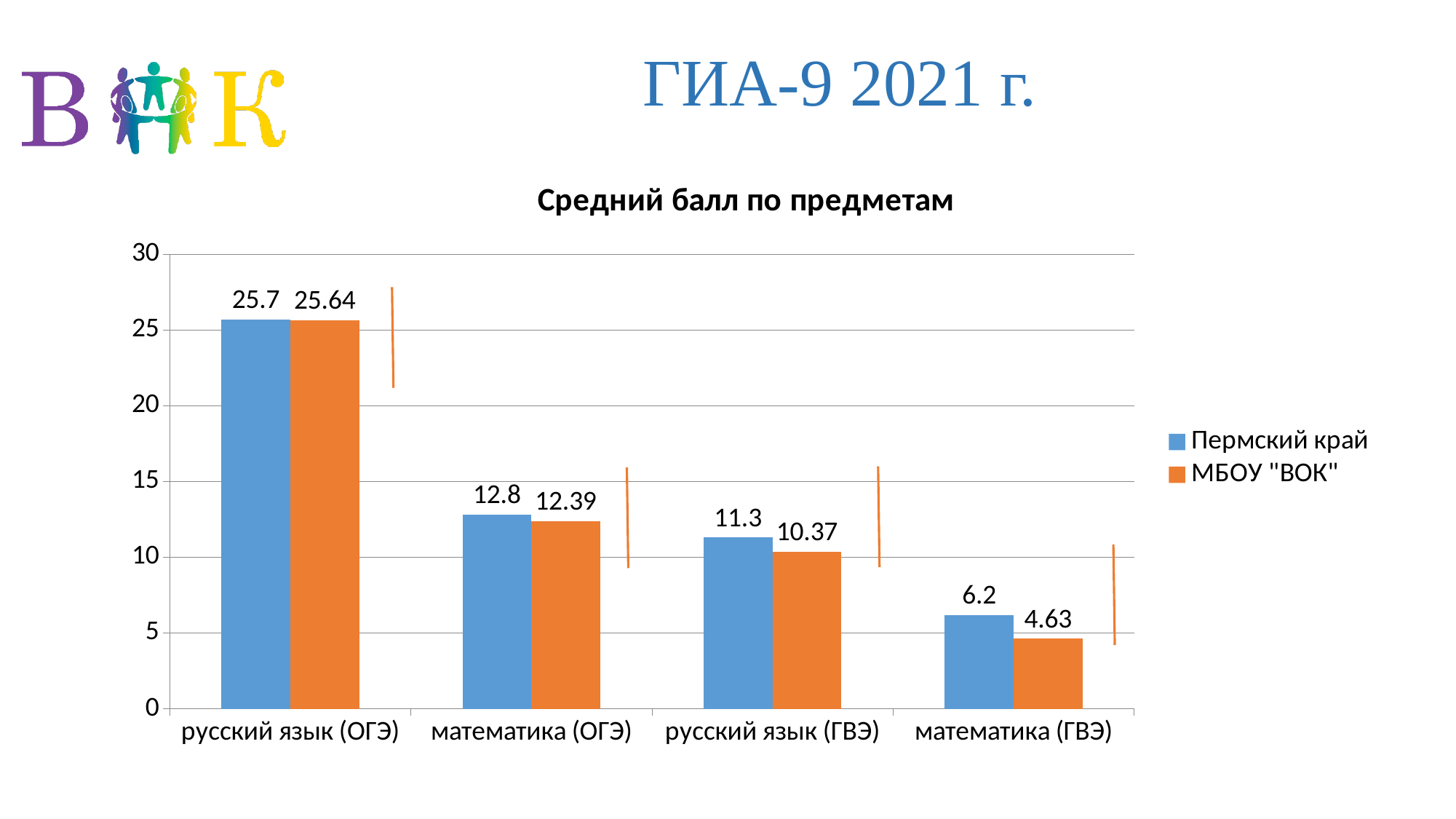
Which is larger in математика (ОГЭ): Пермский край or МБОУ "ВОК"? Пермский край What is the value for МБОУ "ВОК" in русский язык (ГВЭ)? 10.37 What is the value for Пермский край in русский язык (ОГЭ)? 25.7 What is the value for МБОУ "ВОК" in математика (ГВЭ)? 4.63 What kind of chart is shown on the slide? bar chart What is the difference between Пермский край and МБОУ "ВОК" in математика (ГВЭ)? 1.57 Which category has the lowest value for МБОУ "ВОК"? математика (ГВЭ) What is the title of the chart? Средний балл по предметам How many series does the legend list? 2 Which category has the highest value for Пермский край? русский язык (ОГЭ) What is the difference between Пермский край and МБОУ "ВОК" in русский язык (ГВЭ)? 0.93 How many categories are shown on the x axis? 4